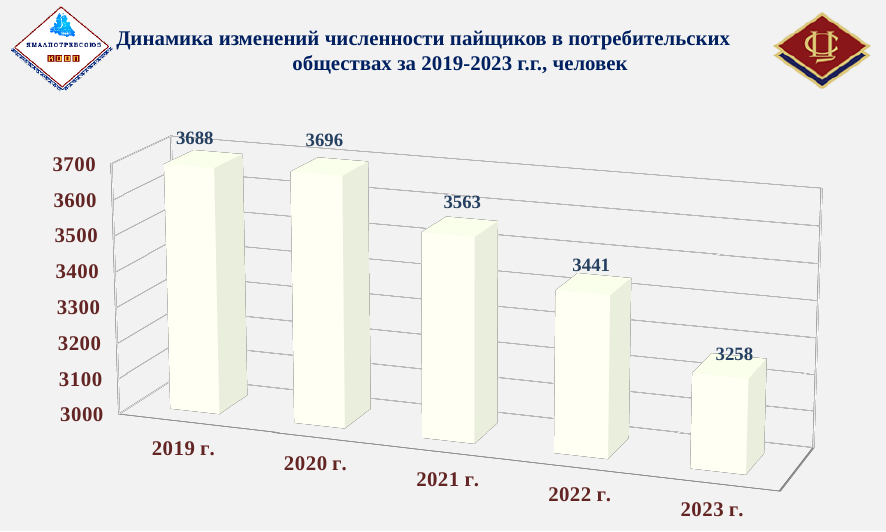
Which year has the highest value? 2020 г. What is the value for 2023 г.? 3258 What is the value for 2021 г.? 3563 How many years are shown on the chart? 5 Do the values generally rise or fall from 2020 г. to 2023 г.? fall What is the value for 2019 г.? 3688 Is the value for 2022 г. greater or less than 3500? less Which year has the lowest value? 2023 г. What is the difference between the values for 2020 г. and 2023 г.? 438 What is the difference between the values for 2021 г. and 2022 г.? 122 What kind of chart is shown on the slide? bar chart Which is larger, the value for 2019 г. or the value for 2022 г.? 2019 г.